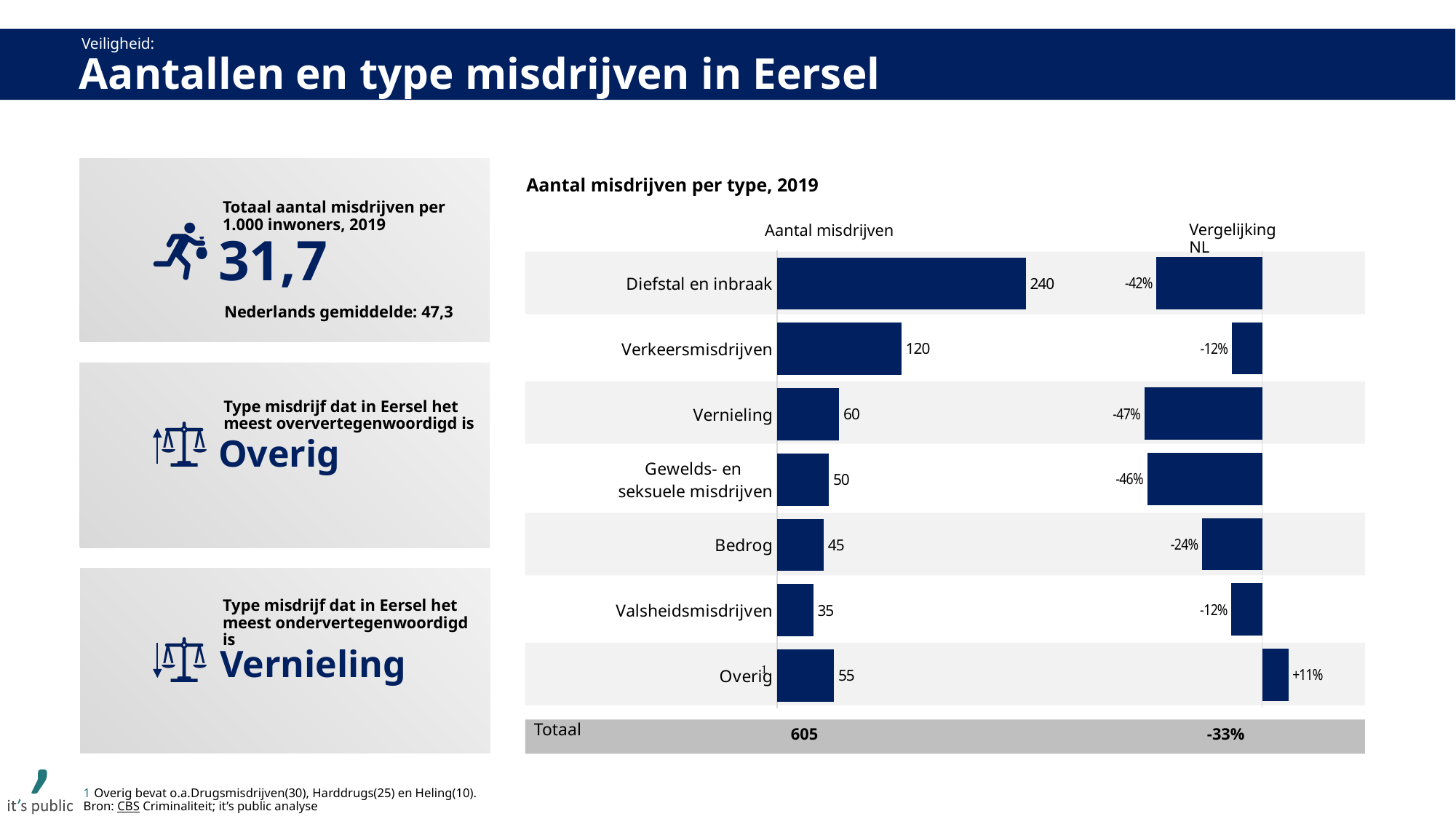
In the chart 'Aantal misdrijven per type, 2019', what is the Aantal misdrijven value for Valsheidsmisdrijven? 35 In the chart 'Aantal misdrijven per type, 2019', which has a higher Aantal misdrijven: Bedrog or Overig? Overig What are the two column headings shown above the bars in the chart 'Aantal misdrijven per type, 2019'? Aantal misdrijven and Vergelijking NL In the chart 'Aantal misdrijven per type, 2019', which crime type has the lowest Aantal misdrijven? Valsheidsmisdrijven In the chart 'Aantal misdrijven per type, 2019', which crime type has the highest Aantal misdrijven? Diefstal en inbraak What type of chart is 'Aantal misdrijven per type, 2019'? Bar chart How many crime types (excluding the Totaal row) are shown in the chart 'Aantal misdrijven per type, 2019'? 7 In the chart 'Aantal misdrijven per type, 2019', what is the number of crimes (Aantal misdrijven) for Diefstal en inbraak? 240 What is the Totaal value for Aantal misdrijven in the chart 'Aantal misdrijven per type, 2019'? 605 In the chart 'Aantal misdrijven per type, 2019', what is the Vergelijking NL value for Vernieling? -47% In the chart 'Aantal misdrijven per type, 2019', which crime type is the only one with a positive Vergelijking NL value? Overig In the chart 'Aantal misdrijven per type, 2019', what is the difference in Aantal misdrijven between Diefstal en inbraak and Verkeersmisdrijven? 120